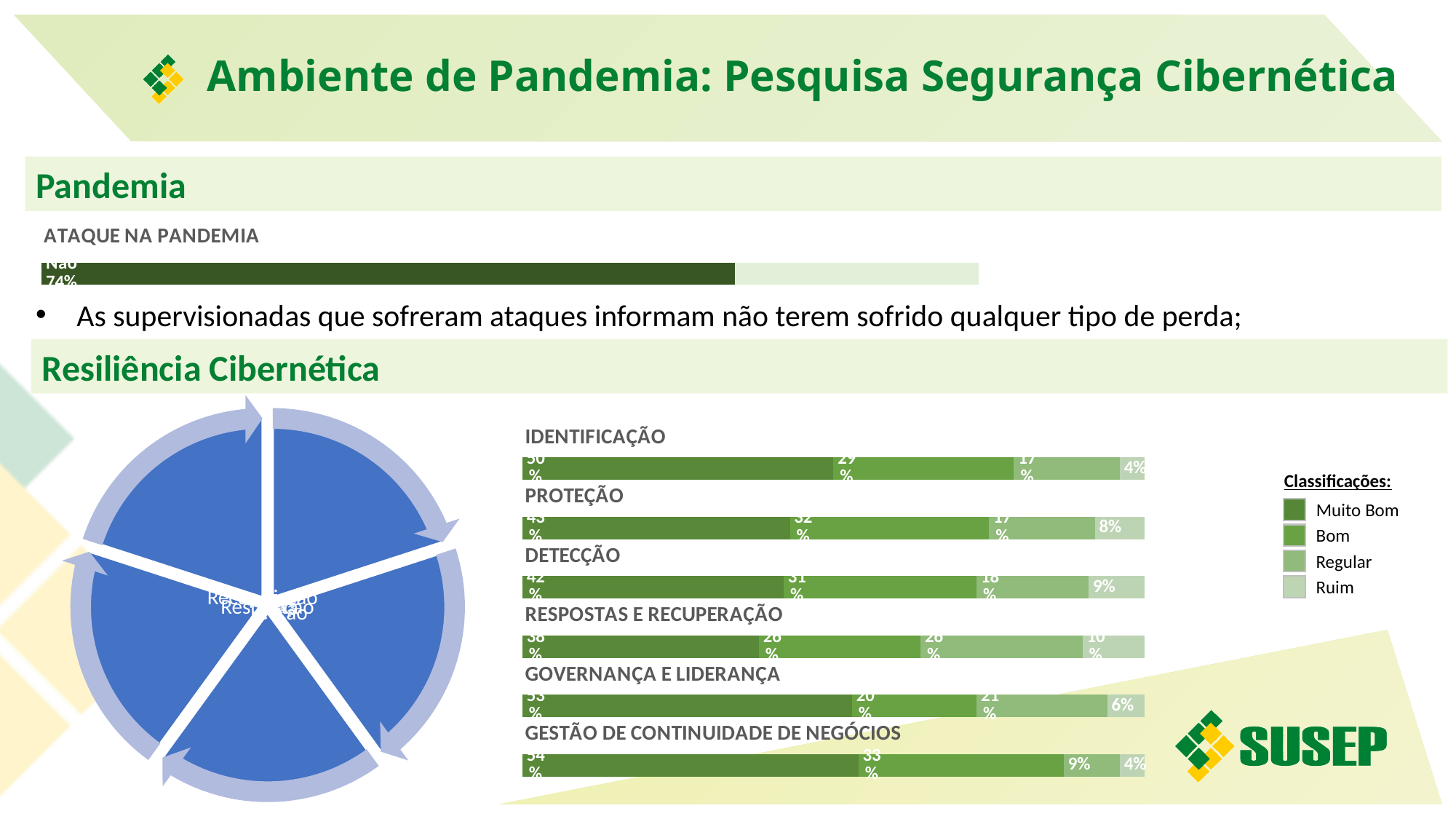
In the ATAQUE NA PANDEMIA chart, what percentage is shown for "Não"? 74% In the Resiliência Cibernética charts, how many classifications does the legend list? 4 In the Resiliência Cibernética charts, what are the legend entries? Muito Bom, Bom, Regular, Ruim In the ATAQUE NA PANDEMIA chart, what kind of chart is used? bar chart In the IDENTIFICAÇÃO bar, what is the value for Muito Bom? 50% In the PROTEÇÃO bar, what is the value for Ruim? 8% In the Resiliência Cibernética section, how many categories (stacked bars) are shown? 6 Across the Resiliência Cibernética bars, which category has the lowest Muito Bom value? RESPOSTAS E RECUPERAÇÃO Across the Resiliência Cibernética bars, which category has the highest Muito Bom value? GESTÃO DE CONTINUIDADE DE NEGÓCIOS Which is larger: the Bom value for GESTÃO DE CONTINUIDADE DE NEGÓCIOS or the Bom value for GOVERNANÇA E LIDERANÇA? GESTÃO DE CONTINUIDADE DE NEGÓCIOS What is the difference between the Muito Bom values for GOVERNANÇA E LIDERANÇA and DETECÇÃO? 11% In the RESPOSTAS E RECUPERAÇÃO bar, what is the value for Regular? 26%